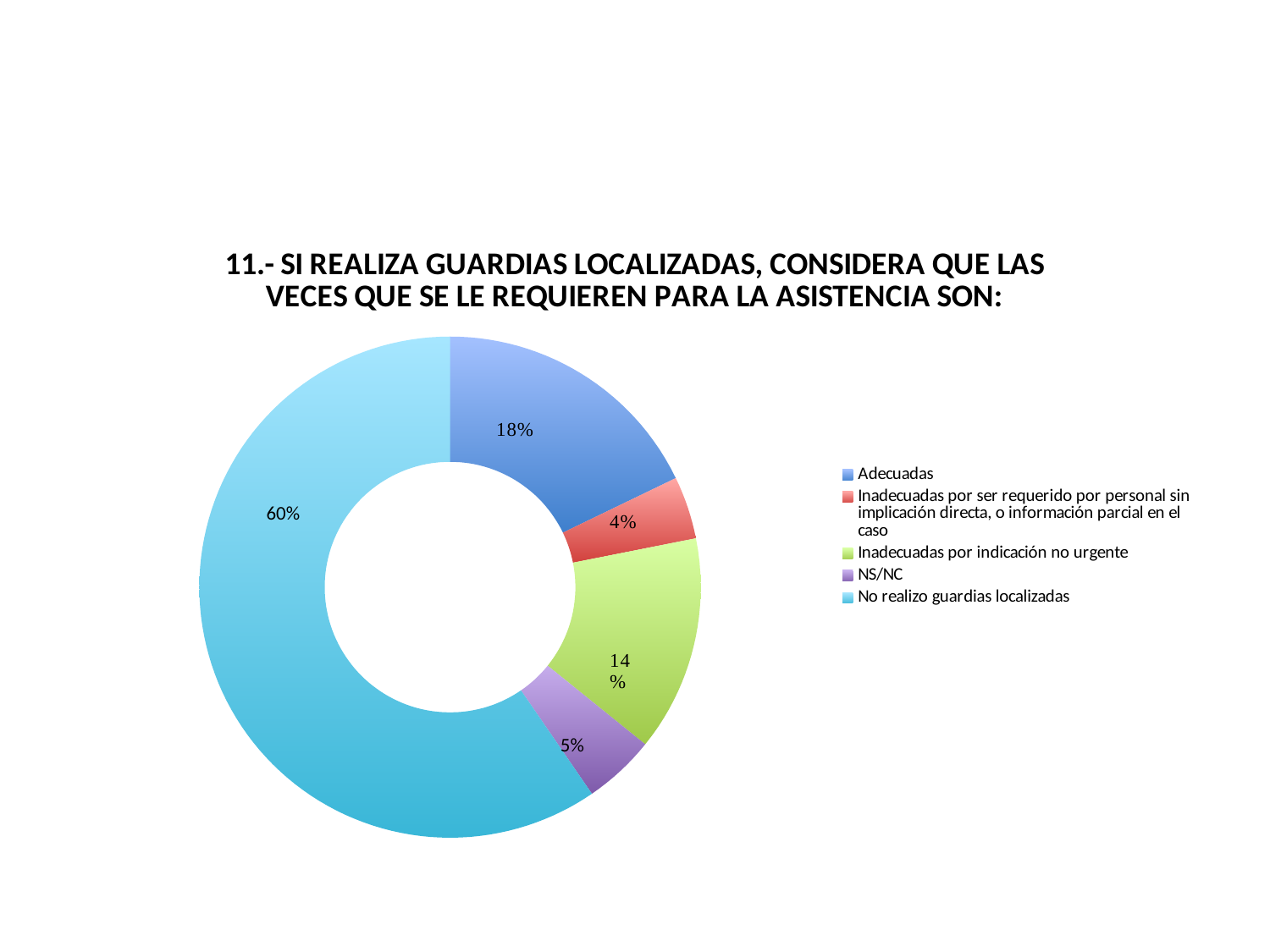
What percentage of the chart is 'Adecuadas'? 18% What percentage of the chart is 'NS/NC'? 5% What percentage of the chart is 'No realizo guardias localizadas'? 60% What percentage of the chart is 'Inadecuadas por indicación no urgente'? 14% What is the difference in percentage points between 'No realizo guardias localizadas' and 'Adecuadas'? 42 What colour is the slice for 'NS/NC'? Purple What percentage of the chart is 'Inadecuadas por ser requerido por personal sin implicación directa, o información parcial en el caso'? 4% What kind of chart is shown on the slide? Doughnut chart Which is larger, the share for 'Adecuadas' or the share for 'Inadecuadas por indicación no urgente'? Adecuadas How many categories does the chart show? 5 Which category has the largest share of the chart? No realizo guardias localizadas Which category has the smallest share of the chart? Inadecuadas por ser requerido por personal sin implicación directa, o información parcial en el caso